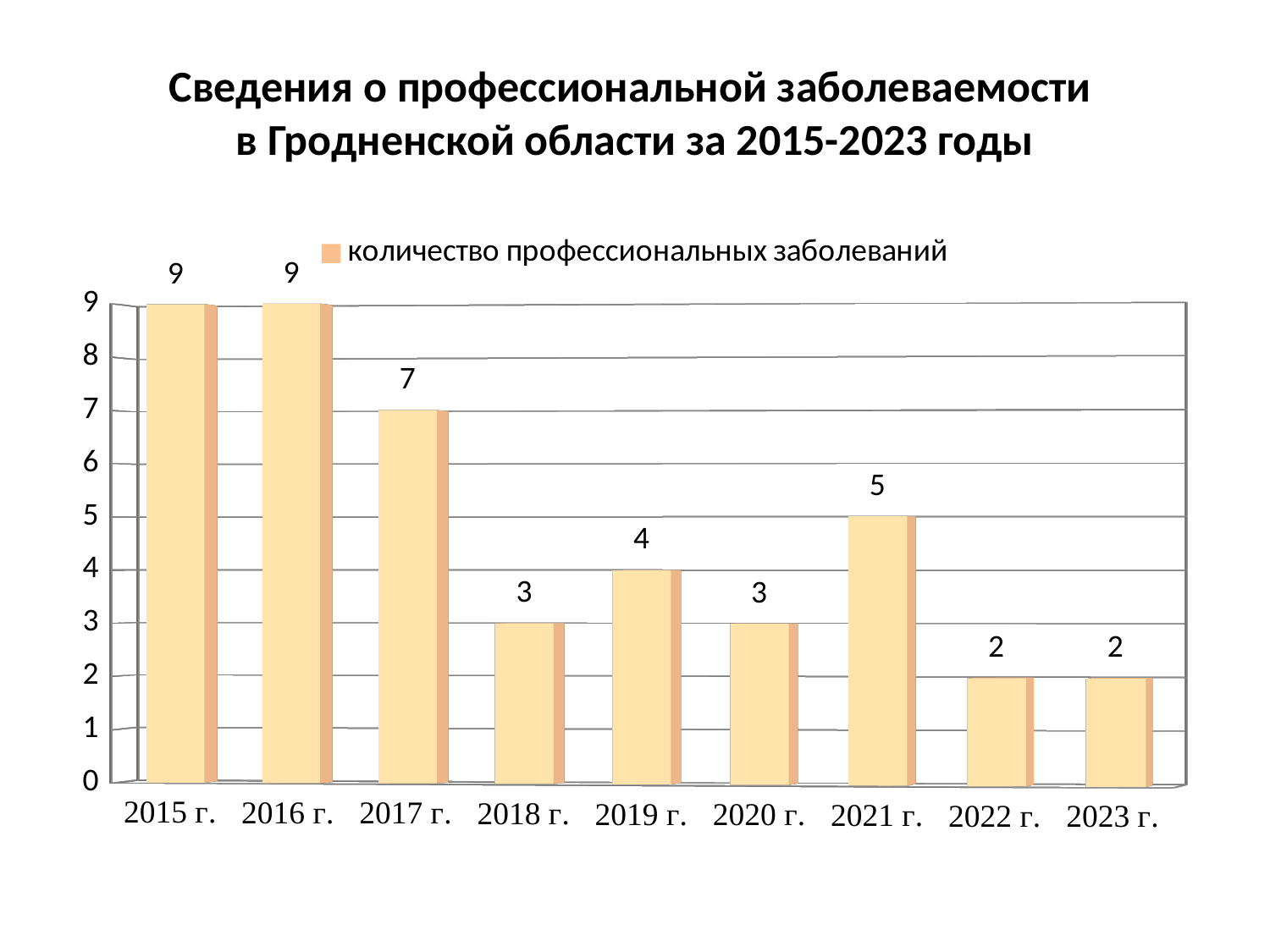
How many series does the legend list? 1 Which year has the lowest value, 2021 г. or 2023 г.? 2023 г. What is the value for 2017 г.? 7 How many years are shown on the x axis? 9 What is the value for 2019 г.? 4 Which is larger, the value for 2019 г. or the value for 2020 г.? 2019 г. What kind of chart is shown on the slide? bar chart What is the value for 2021 г.? 5 What is the difference between the values for 2021 г. and 2022 г.? 3 What is the difference between the values for 2016 г. and 2017 г.? 2 Is the value for 2017 г. greater or less than 5? greater Do the values generally rise or fall from 2015 г. to 2023 г.? fall